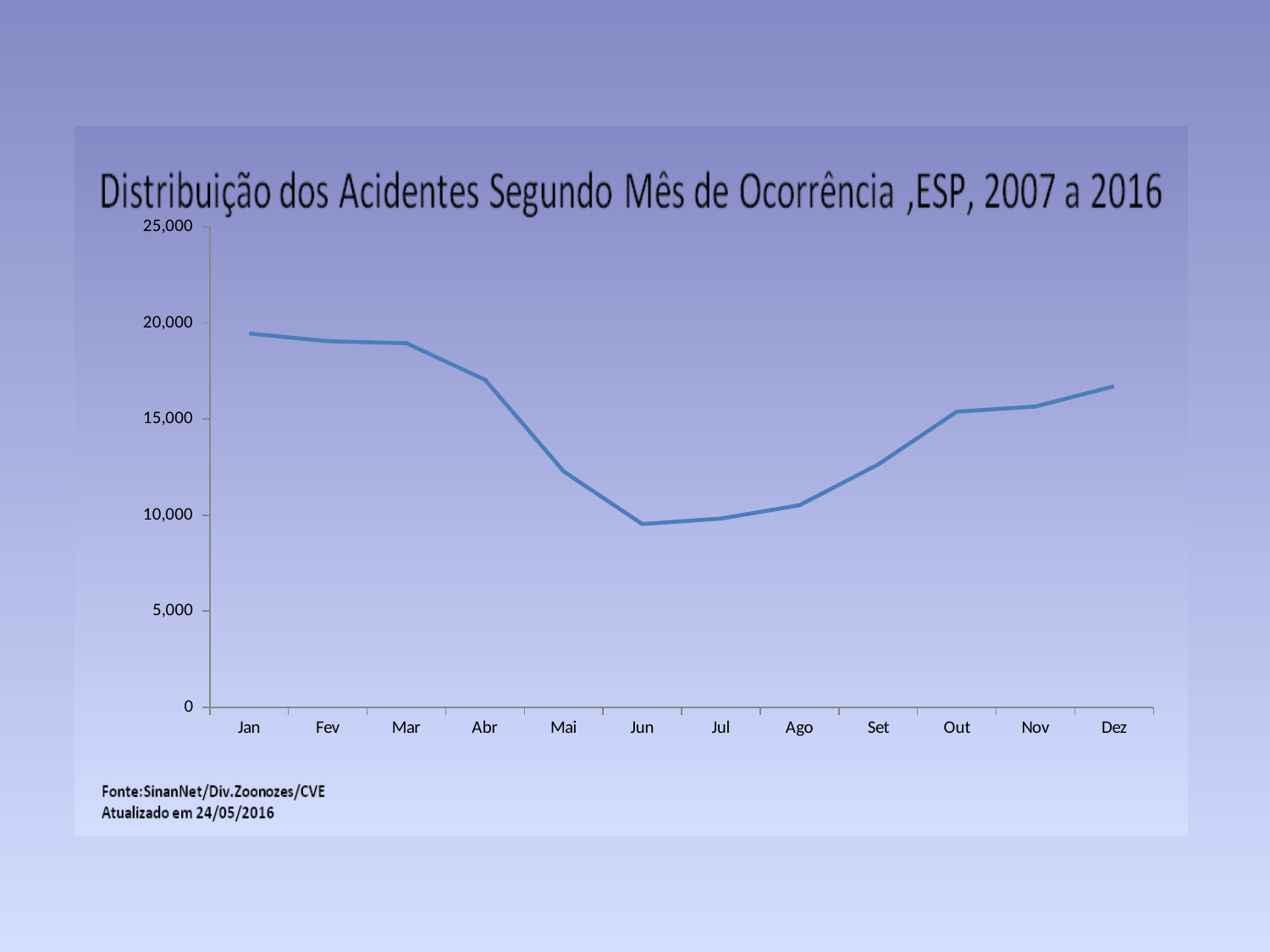
Which is larger, the value for Abr or the value for Set? Abr Which is larger, the value for Ago or the value for Out? Out Is the value for Jun greater or less than 10,000? less Which month has the lowest value? Jun What kind of chart is shown on the slide? line chart Which month has the highest value? Jan Do the values rise or fall from Jan to Jun? fall Is the value for Dez greater or less than 15,000? greater How many months are plotted along the x axis? 12 What is the title of the chart? Distribuição dos Acidentes Segundo Mês de Ocorrência ,ESP, 2007 a 2016 Is the value for Jan greater or less than 15,000? greater